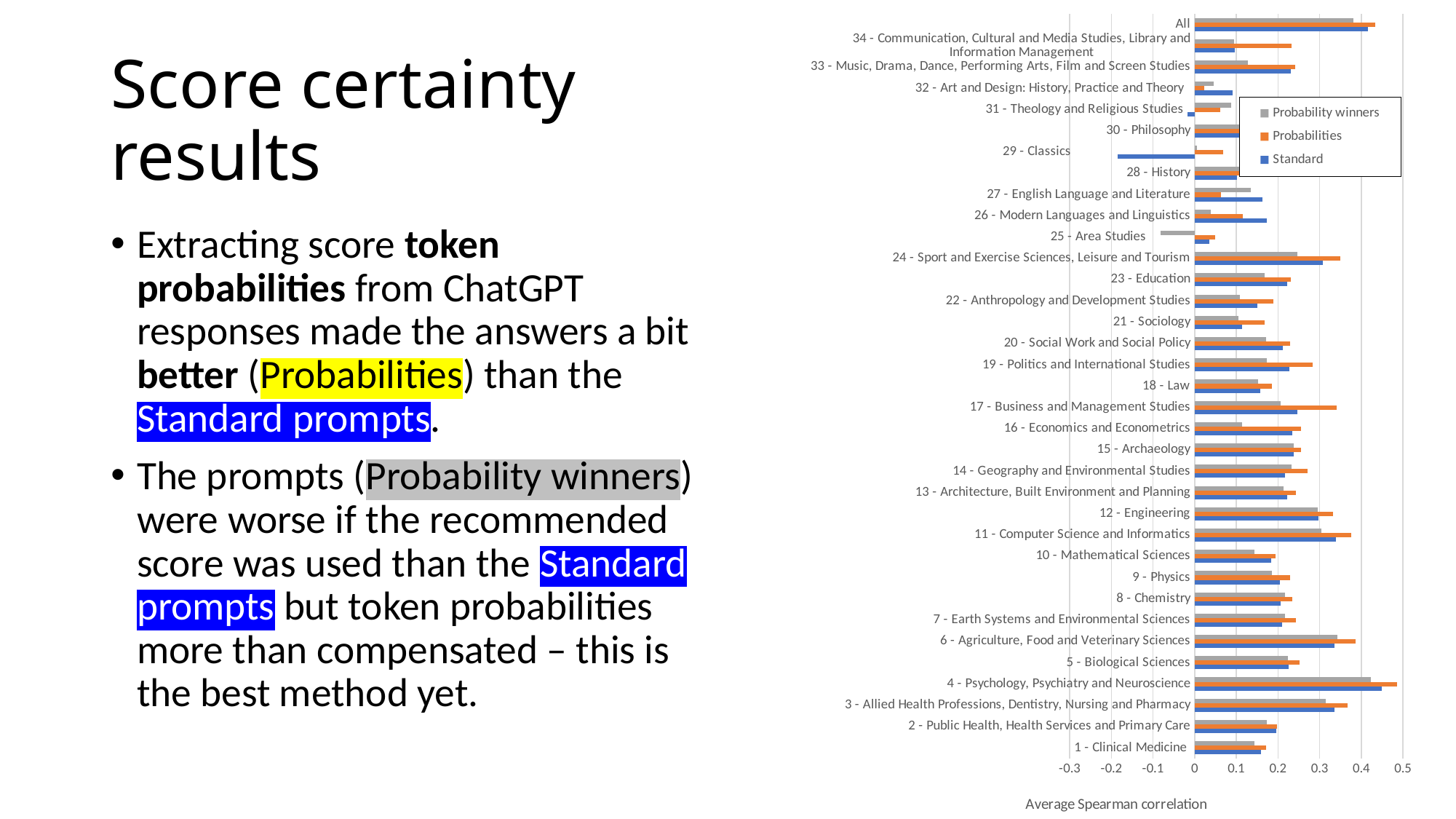
How many categories are plotted on the chart, including 'All'? 35 Is the Probabilities value for 'All' greater or less than 0.4? greater What is the title of the horizontal axis of the chart? Average Spearman correlation Is the Standard value for '1 - Clinical Medicine' greater or less than 0.2? less Which category has the lowest Standard value? 29 - Classics What are the three series named in the chart's legend? Probability winners, Probabilities, Standard How many series does the chart's legend list? 3 Is the Standard value for '29 - Classics' greater or less than 0? less For '17 - Business and Management Studies', which is larger: the Probabilities value or the Standard value? Probabilities What kind of chart is shown on the slide? bar chart Which category has the highest Probabilities value? 4 - Psychology, Psychiatry and Neuroscience